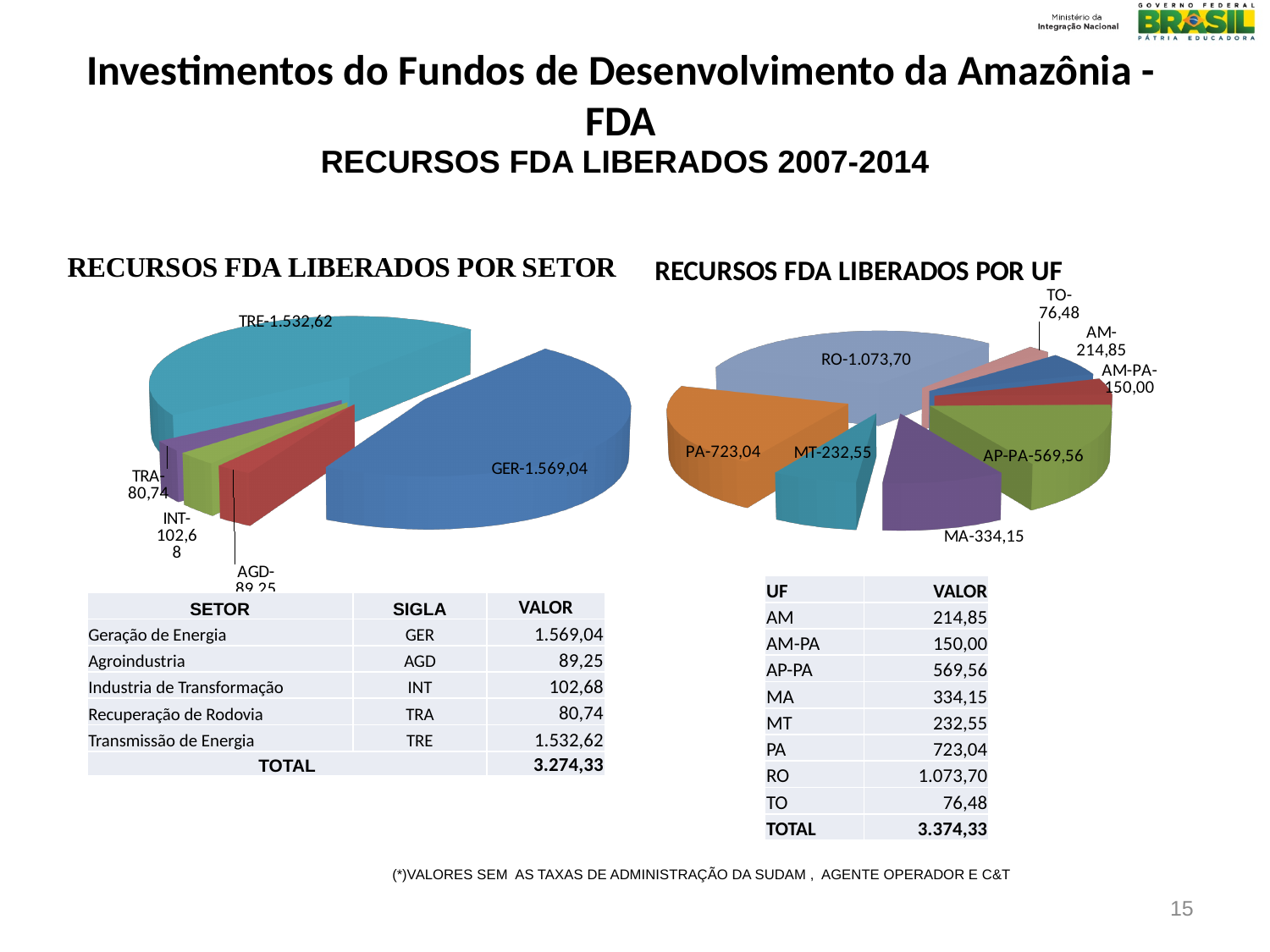
In the 'RECURSOS FDA LIBERADOS POR SETOR' chart, what is the value for INT? 102,68 In the 'RECURSOS FDA LIBERADOS POR UF' chart, what is the value for MA? 334,15 In the 'RECURSOS FDA LIBERADOS POR SETOR' chart, which sector has the largest value? GER In the 'RECURSOS FDA LIBERADOS POR SETOR' chart, how many sectors are shown? 5 In the 'RECURSOS FDA LIBERADOS POR UF' chart, which is larger, PA or AP-PA? PA In the 'RECURSOS FDA LIBERADOS POR UF' chart, what is the difference between the RO and PA values? 350,66 In the 'RECURSOS FDA LIBERADOS POR SETOR' chart, what is the value for GER? 1.569,04 In the 'RECURSOS FDA LIBERADOS POR UF' chart, which UF has the smallest value? TO In the 'RECURSOS FDA LIBERADOS POR UF' chart, what is the value for RO? 1.073,70 In the 'RECURSOS FDA LIBERADOS POR SETOR' chart, which sector has the smallest value? TRA In the 'RECURSOS FDA LIBERADOS POR SETOR' chart, what is the difference between the GER and TRE values? 36,42 What type of chart is 'RECURSOS FDA LIBERADOS POR UF'? Pie chart